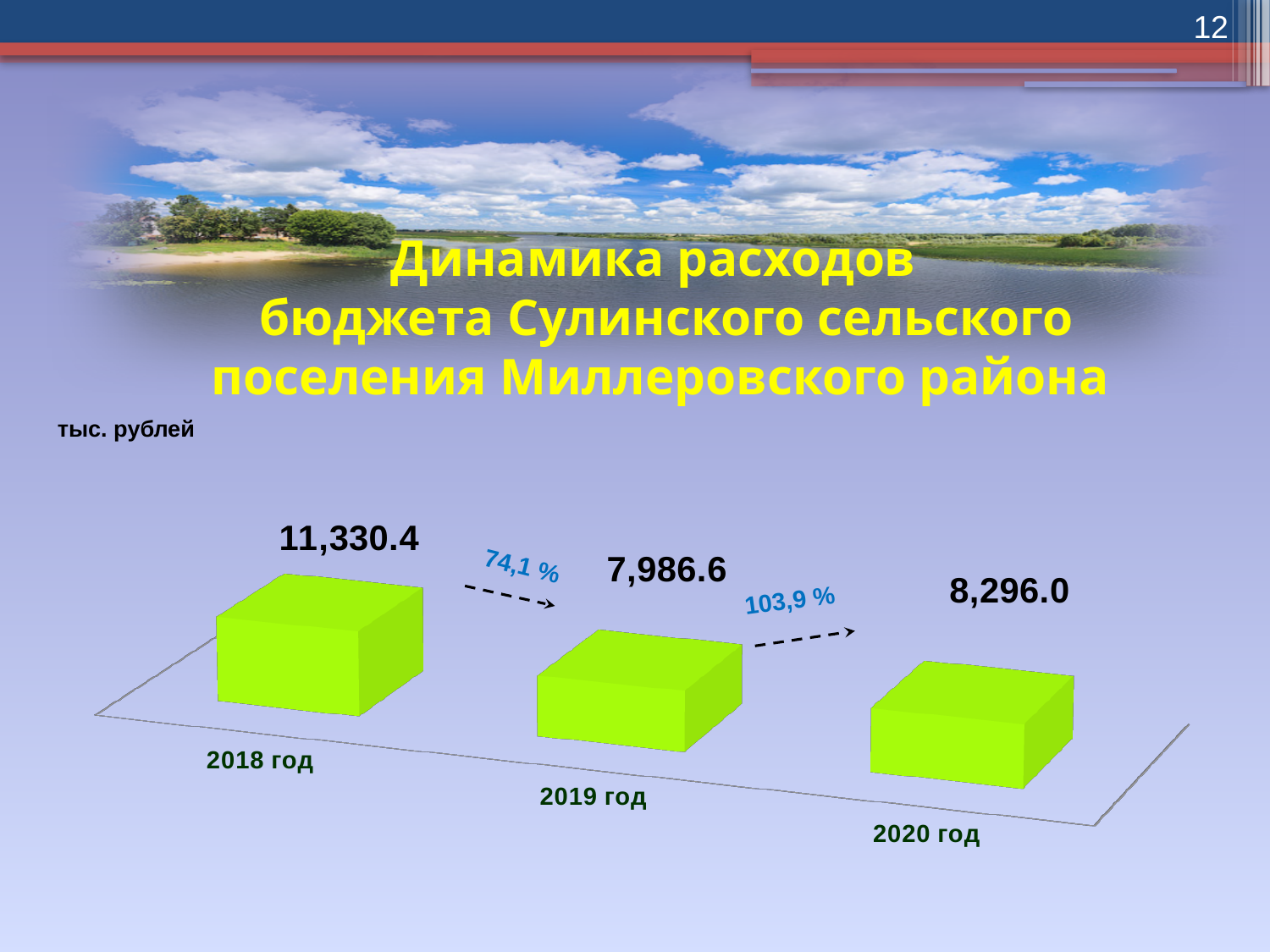
Which year has the lowest expenditure value on the chart? 2019 год What is the difference between the 2020 год and 2019 год values? 309.4 Which is larger, the value for 2019 год or the value for 2020 год? 2020 год What is the budget expenditure value shown for 2020 год? 8,296.0 How many years (categories) are shown on the chart? 3 In what units are the chart values expressed, according to the label on the slide? тыс. рублей What percentage label is shown on the arrow between 2018 год and 2019 год? 74,1 % What kind of chart is shown on the slide? bar chart Which year has the highest expenditure value on the chart? 2018 год What is the budget expenditure value shown for 2019 год? 7,986.6 What is the budget expenditure value shown for 2018 год? 11,330.4 What is the difference between the 2018 год and 2019 год values? 3,343.8